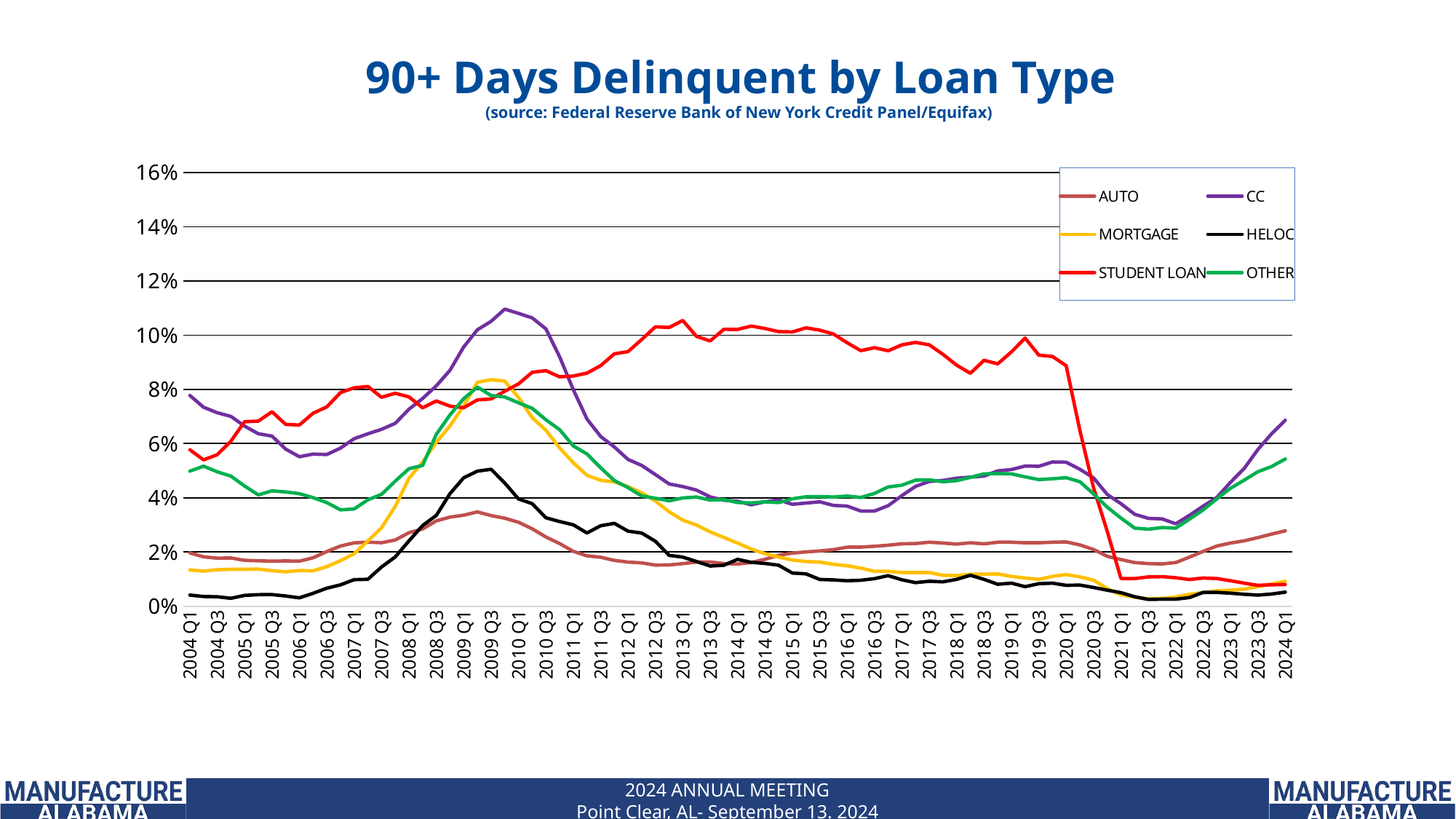
Is the value for MORTGAGE at 2009 Q3 greater or less than 6%? greater What colour is the STUDENT LOAN line? red Is the value for HELOC at 2021 Q3 greater or less than 1%? less What is the title of the chart? 90+ Days Delinquent by Loan Type Is the value for CC at 2009 Q3 greater or less than 10%? greater Does the STUDENT LOAN line rise or fall between 2020 Q1 and 2021 Q1? fall Does the CC line rise or fall between 2022 Q1 and 2024 Q1? rise How many series does the legend list? 6 Which series has the highest value at 2024 Q1? CC What kind of chart is shown on the slide? line chart At 2024 Q1, which is larger, CC or AUTO? CC